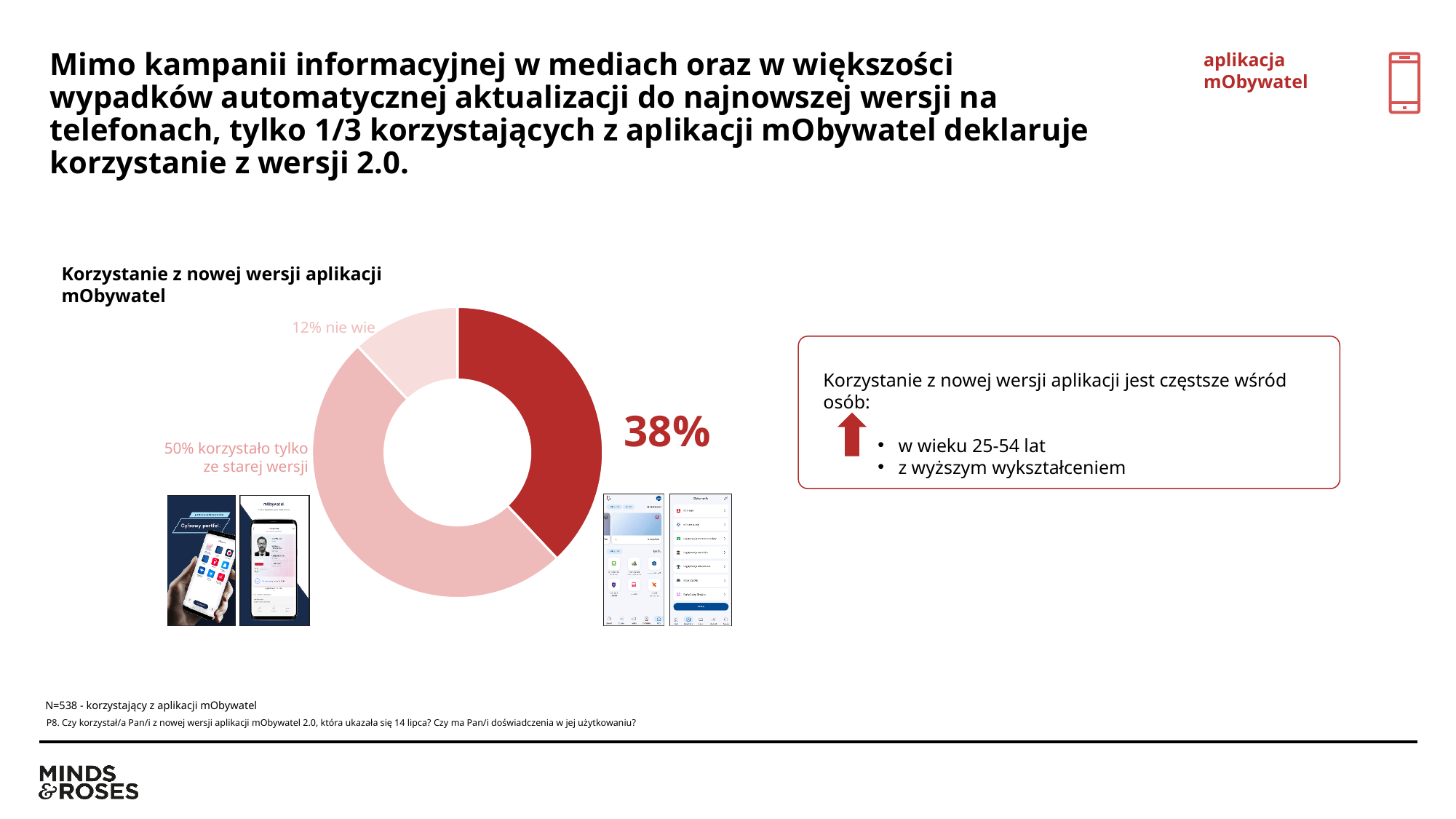
What is the sample size (N) stated below the chart? N=538 Which slice of the donut chart is the smallest? 12% nie wie What percentage is shown for the dark red slice of the donut chart? 38% What is the combined share of the "50% korzystało tylko ze starej wersji" and "12% nie wie" slices? 62% What kind of chart is shown under the title "Korzystanie z nowej wersji aplikacji mObywatel"? Donut (pie) chart Which slice of the donut chart is the largest? 50% korzystało tylko ze starej wersji What is the title of the chart on the slide? Korzystanie z nowej wersji aplikacji mObywatel How many slices does the donut chart have? 3 What share of respondents "korzystało tylko ze starej wersji"? 50% What share of respondents answered "nie wie"? 12% What is the difference between the share that used only the old version and the share using the new version (38%)? 12 percentage points Which is larger: the 38% slice or the "nie wie" slice? The 38% slice